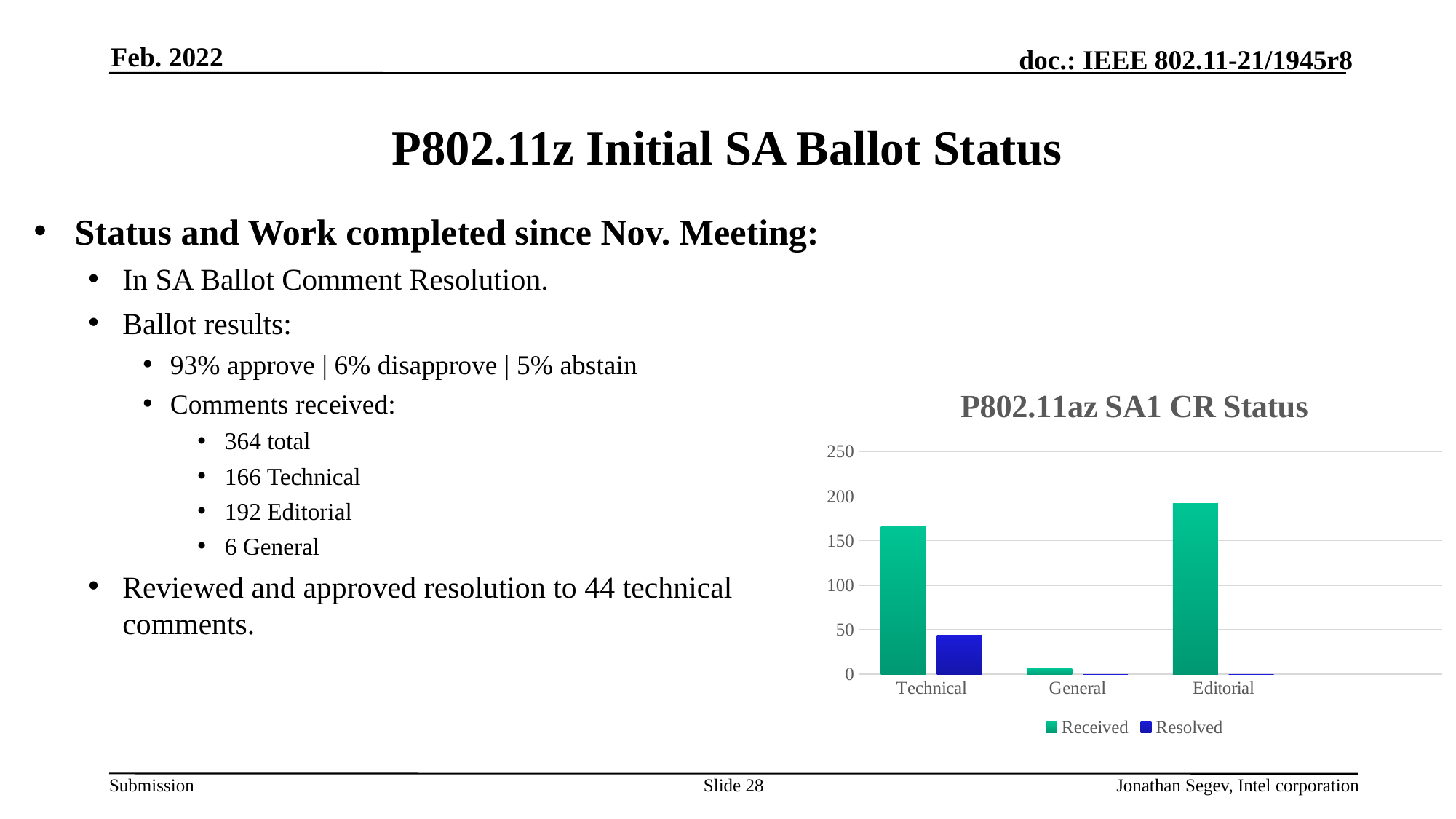
Which category has the lowest Received value? General Is the Received value for Technical greater or less than 150? greater How many series does the chart's legend list? 2 Which is larger, the Received value for Technical or the Received value for Editorial? Editorial Is the Resolved value for Technical greater or less than 50? less Which series is shown in blue in the chart? Resolved How many categories are shown on the x axis of the chart? 3 What kind of chart is shown on the slide? bar chart Is the Received value for Editorial greater or less than 200? less Which is larger for Technical, the Received value or the Resolved value? Received Which category has the highest Received value? Editorial What is the title of the chart on the slide? P802.11az SA1 CR Status